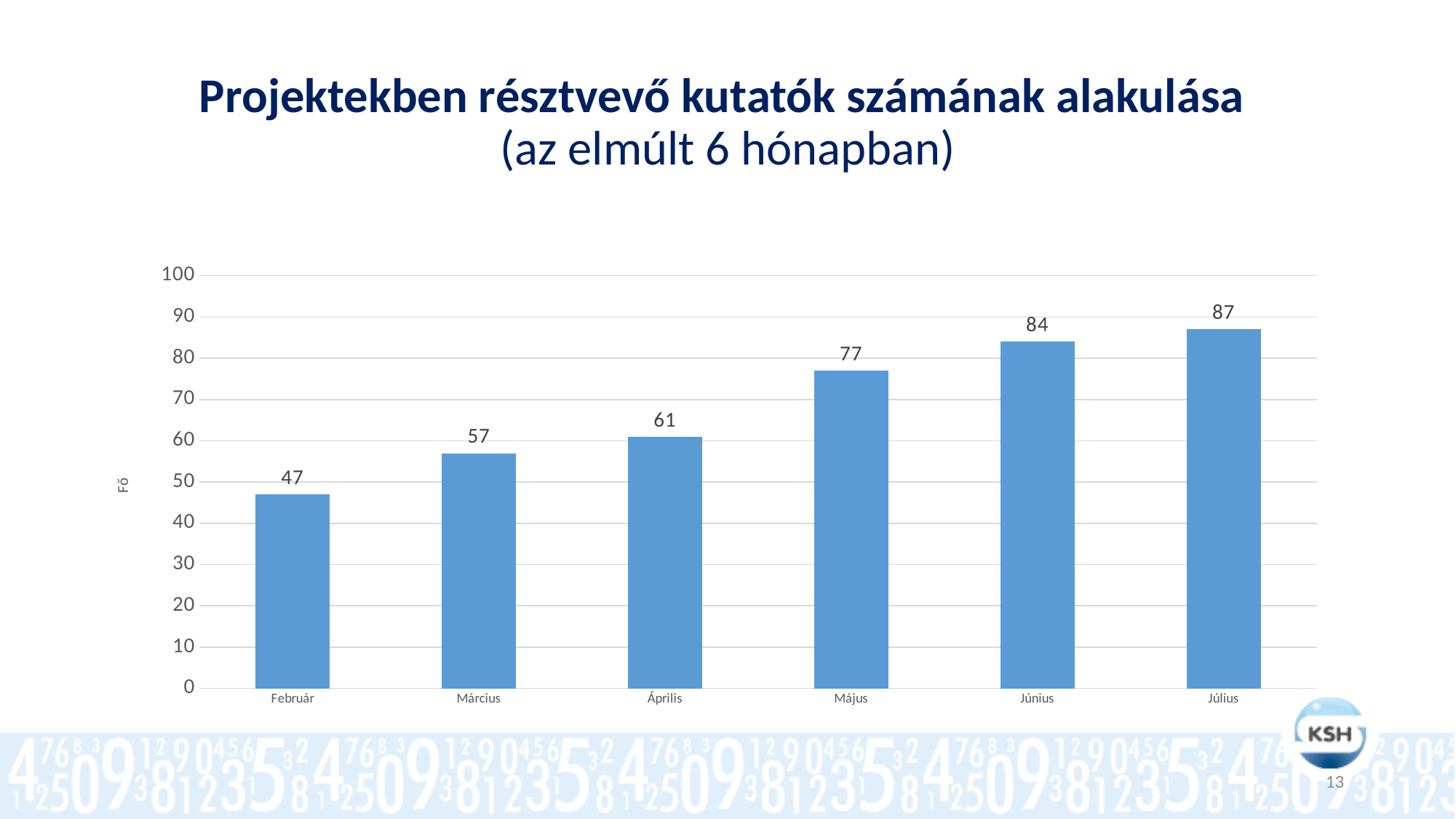
Do the values rise or fall from Február to Július? rise What is the value for Június? 84 Which is larger, the value for Május or the value for Április? Május What is the difference between the values for Július and Február? 40 Which month has the highest value? Július What is the difference between the values for Április and Március? 4 Is the value for Június greater or less than 80? greater Which month has the lowest value? Február How many months are shown on the x axis? 6 What kind of chart is shown on the slide? bar chart What is the value for Február? 47 What is the value for Május? 77